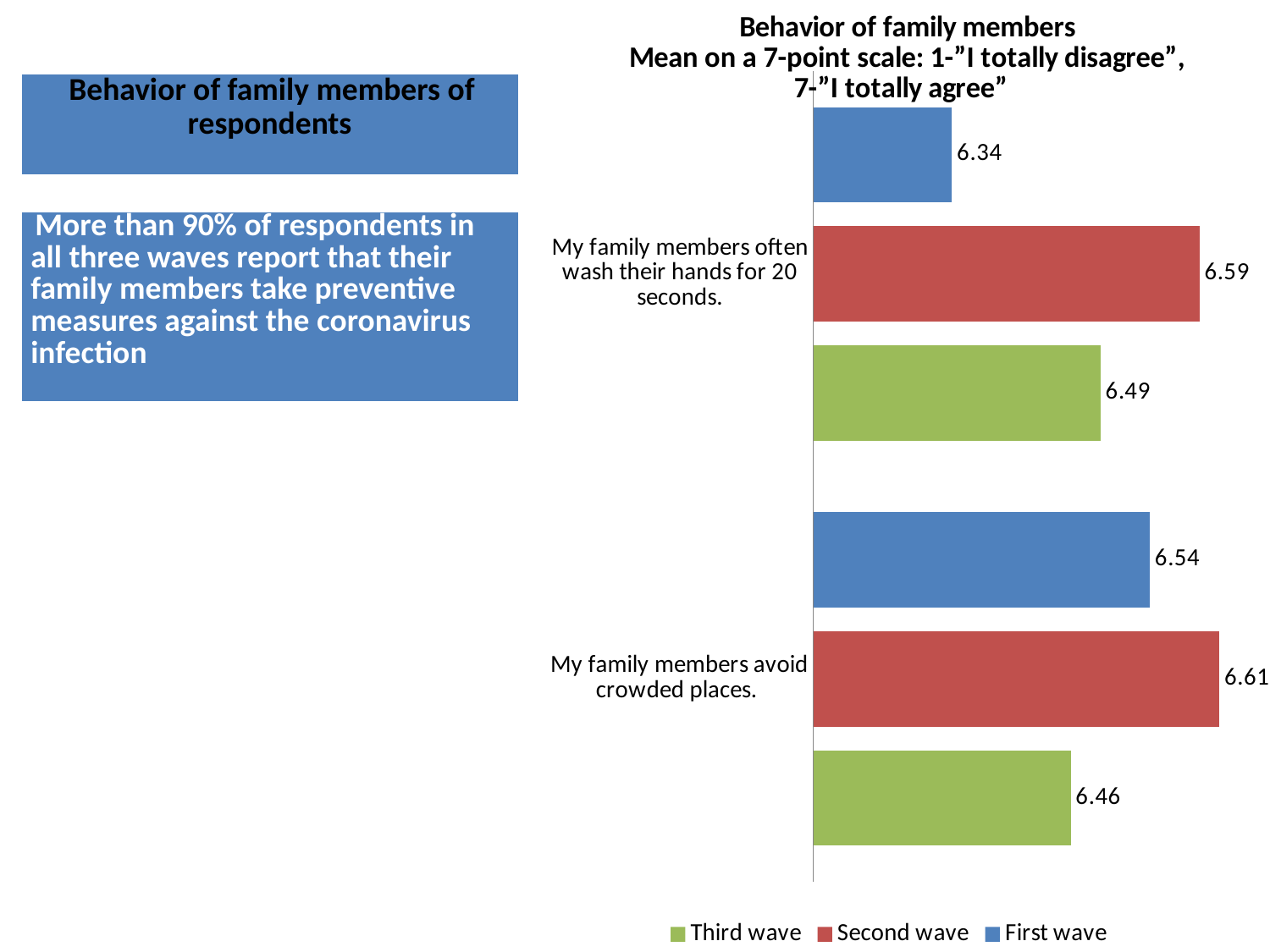
Which is larger: the First wave value for "My family members avoid crowded places." or the First wave value for "My family members often wash their hands for 20 seconds."? My family members avoid crowded places. How many series does the legend list? 3 What is the Second wave value for "My family members avoid crowded places."? 6.61 What is the First wave value for "My family members often wash their hands for 20 seconds."? 6.34 Which wave has the highest value for "My family members often wash their hands for 20 seconds."? Second wave Which colour represents the Second wave in the chart? Red How many statements (categories) are shown on the chart? 2 What is the Third wave value for "My family members avoid crowded places."? 6.46 What is the difference between the Second wave and First wave values for "My family members often wash their hands for 20 seconds."? 0.25 What kind of chart is shown on the slide? Bar chart Which wave has the lowest value for "My family members avoid crowded places."? Third wave What is the Third wave value for "My family members often wash their hands for 20 seconds."? 6.49